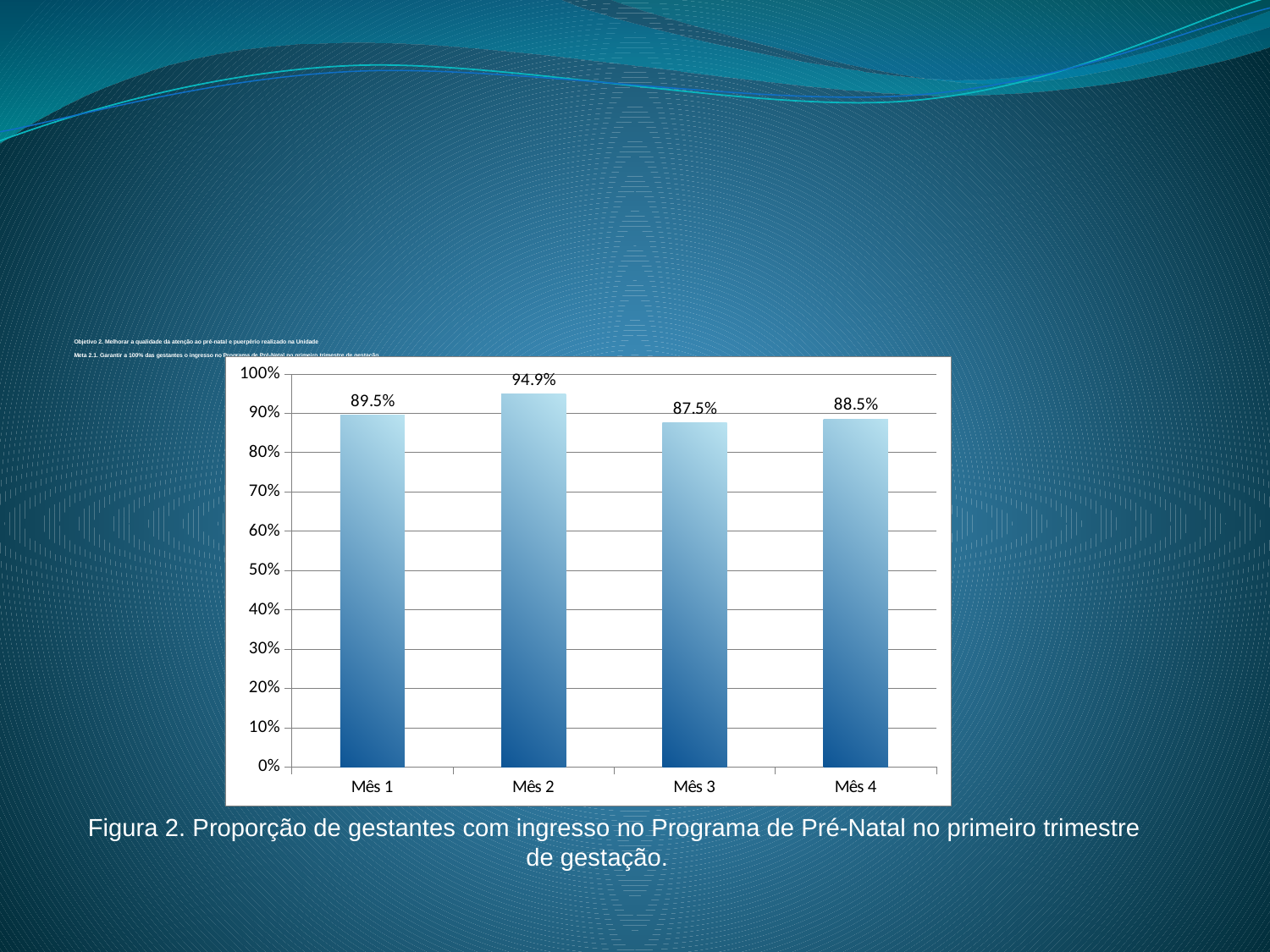
Which is larger, the value for Mês 1 or the value for Mês 4? Mês 1 Is the value for Mês 3 greater or less than 90%? less What is the difference between the values for Mês 2 and Mês 3? 7.4% How many months are shown on the x axis? 4 What kind of chart is shown on the slide? bar chart What is the value for Mês 3? 87.5% What is the value for Mês 2? 94.9% What is the value for Mês 1? 89.5% Which month has the highest value? Mês 2 What is the figure caption below the chart? Figura 2. Proporção de gestantes com ingresso no Programa de Pré-Natal no primeiro trimestre de gestação. Which month has the lowest value? Mês 3 What is the value for Mês 4? 88.5%